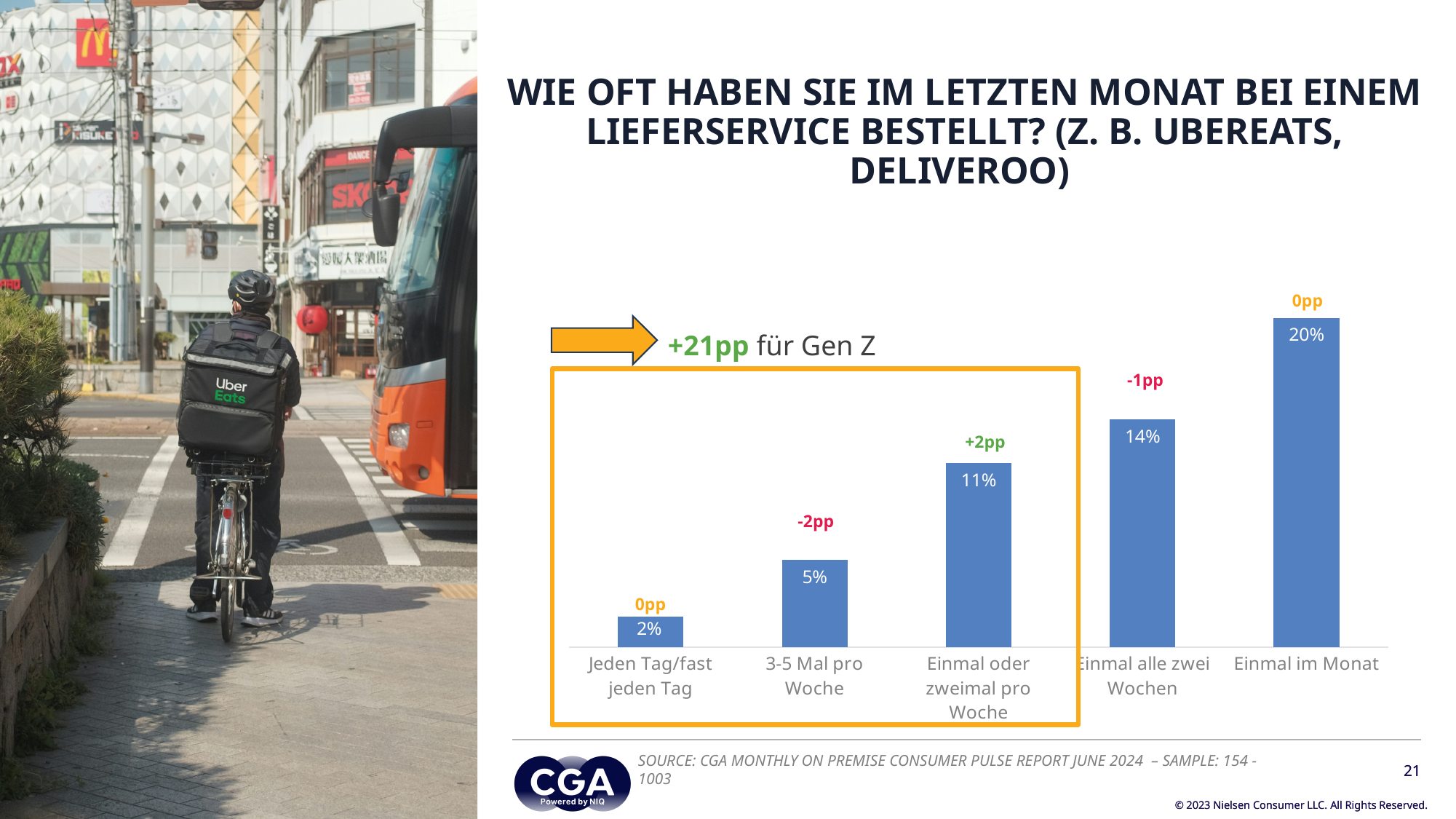
Which category has the highest value? Einmal im Monat How many categories are shown on the chart? 5 Do the values rise or fall from left to right along the x axis? Rise Which is larger: the value for "3-5 Mal pro Woche" or "Einmal oder zweimal pro Woche"? Einmal oder zweimal pro Woche Which category has the lowest value? Jeden Tag/fast jeden Tag What is the value for "3-5 Mal pro Woche"? 5% What kind of chart is shown on the slide? Bar chart What change for Gen Z is noted next to the orange arrow? +21pp What percentage of respondents ordered from a delivery service once a month ("Einmal im Monat")? 20% What is the difference between the values for "Einmal im Monat" and "Einmal alle zwei Wochen"? 6% What is the value for "Einmal oder zweimal pro Woche"? 11% What change in percentage points is shown above the "3-5 Mal pro Woche" bar? -2pp